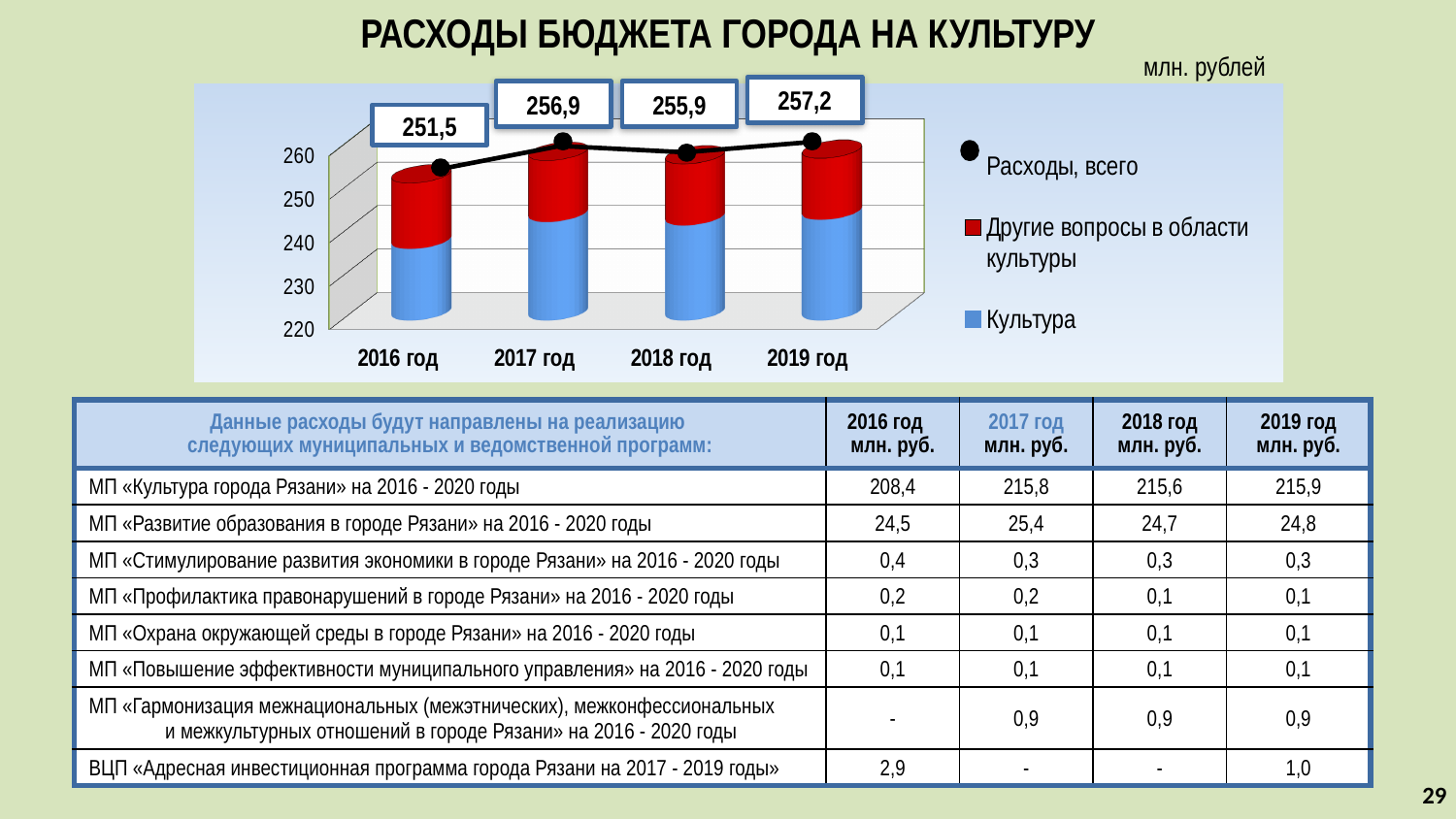
Is the value of «Культура» for 2016 год greater or less than 250? less What is the value of «Расходы, всего» for 2019 год? 257,2 How many series does the chart legend list? 3 In which year is «Расходы, всего» the highest? 2019 год What is the value of «Расходы, всего» for 2018 год? 255,9 What unit is indicated for the chart values? млн. рублей Which is larger, «Расходы, всего» in 2017 год or in 2018 год? 2017 год What kind of chart is shown on the slide? bar chart What is the value of «Расходы, всего» for 2016 год? 251,5 In which year is «Расходы, всего» the lowest? 2016 год How many years are shown on the x axis of the chart? 4 What is the difference between «Расходы, всего» in 2017 год and 2016 год? 5,4